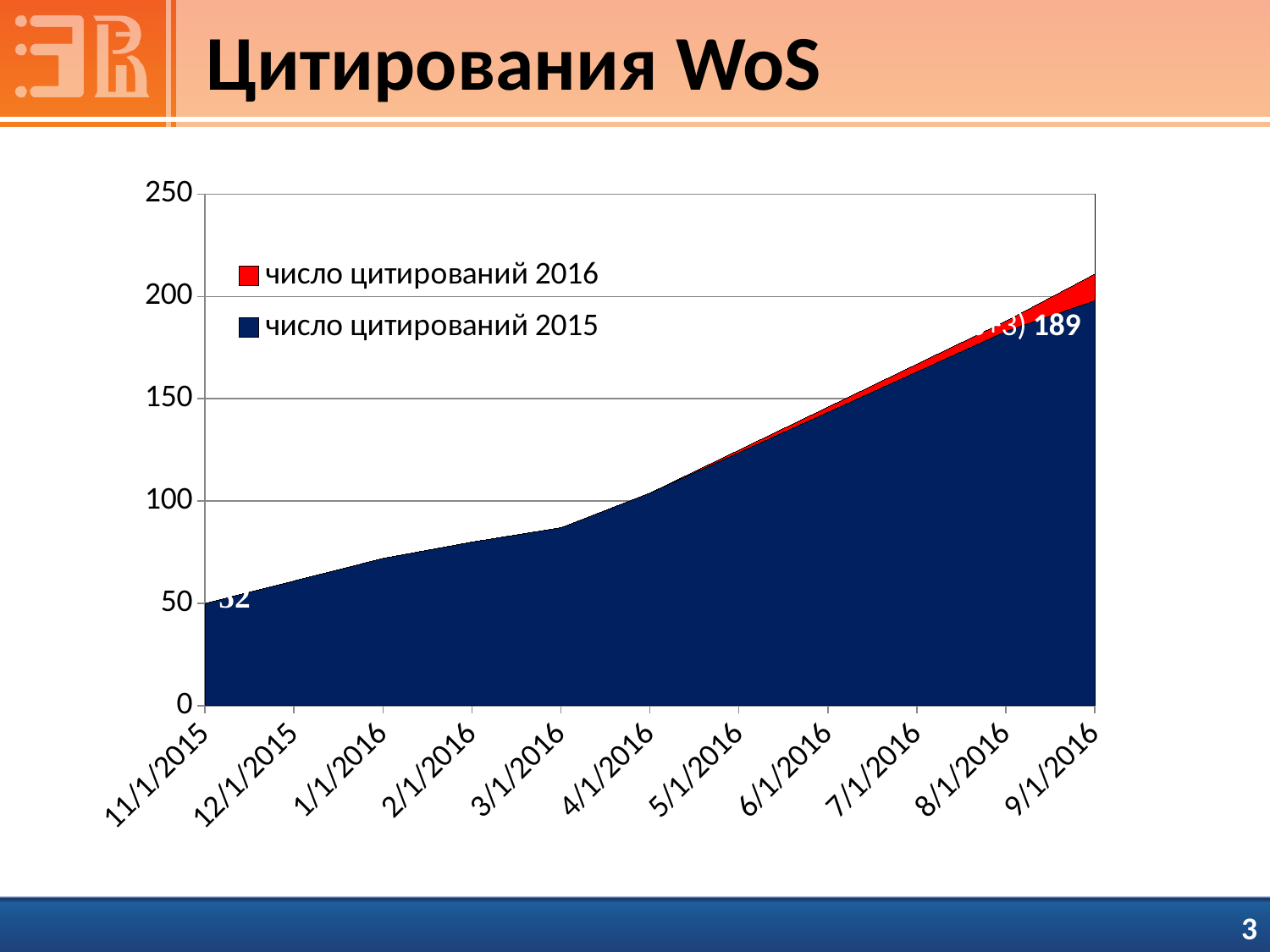
At which date is 'число цитирований 2015' highest? 9/1/2016 Do the values of 'число цитирований 2015' rise or fall from 11/1/2015 to 9/1/2016? rise How many series does the legend list? 2 At which date is 'число цитирований 2015' lowest? 11/1/2015 Is the value of 'число цитирований 2015' at 3/1/2016 greater or less than 100? less What kind of chart is shown on the slide? area chart How many dates are shown along the x axis? 11 Is the value of 'число цитирований 2015' at 5/1/2016 greater or less than 100? greater Which colour represents 'число цитирований 2016' in the chart? red Is the value of 'число цитирований 2015' at 1/1/2016 greater or less than 100? less